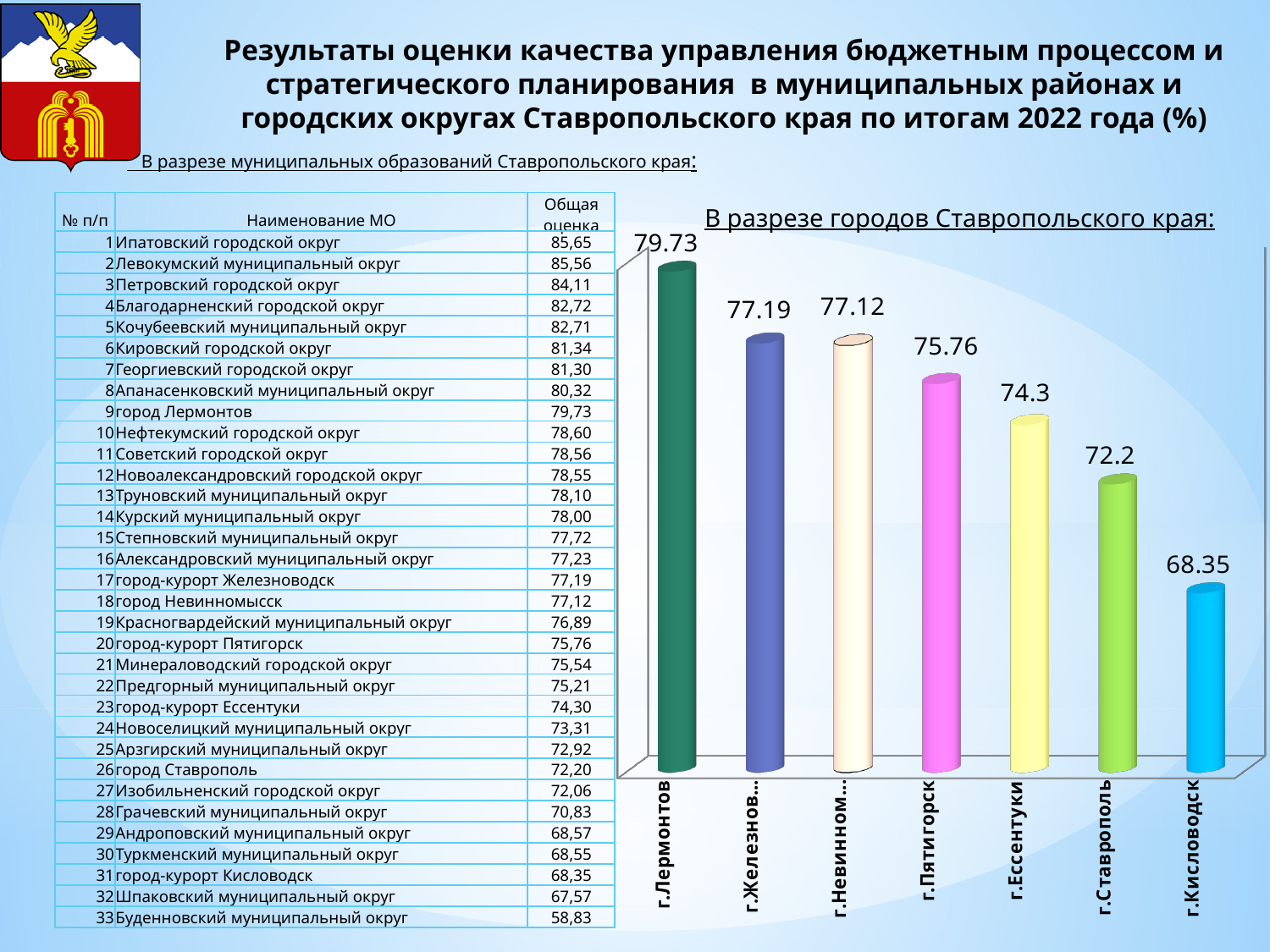
Which city has the highest value in the chart? г.Лермонтов Do the values in the chart rise or fall from left to right? fall What is the value for г.Лермонтов in the chart? 79.73 What type of chart is shown on the slide? bar chart Which city has the lowest value in the chart? г.Кисловодск What is the difference between the values for г.Лермонтов and г.Кисловодск in the chart? 11.38 How many cities are plotted in the chart? 7 What is the value for г.Кисловодск in the chart? 68.35 What is the value for г.Ессентуки in the chart? 74.3 What is the value for г.Пятигорск in the chart? 75.76 Which has a larger value in the chart, г.Ставрополь or г.Ессентуки? г.Ессентуки What is the title of the chart on the slide? В разрезе городов Ставропольского края: